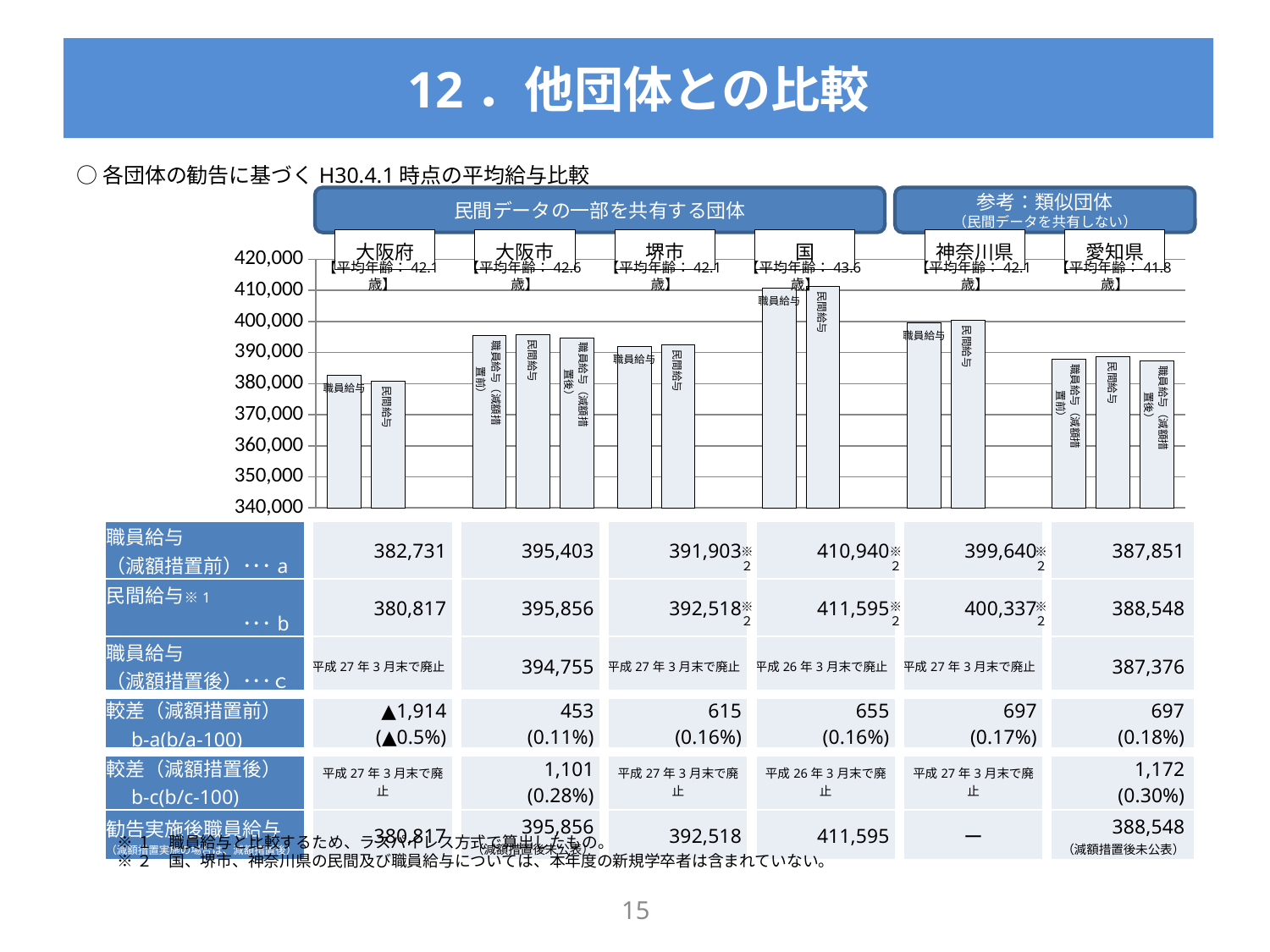
What is the difference (較差, b-a) between 民間給与 and 職員給与（減額措置前） for 大阪市? 453 What kind of chart is shown on the slide? bar chart How many organizations (団体) are compared in the chart? 6 What average age (平均年齢) is shown for 国 in the chart? 43.6歳 What is the 職員給与（減額措置前） value for 大阪府? 382,731 Which organization has the lowest 民間給与? 大阪府 Is the 民間給与 value for 国 greater or less than 400,000? greater What is the 職員給与（減額措置後） value for 愛知県? 387,376 What is the 民間給与 value for 国? 411,595 Is the 民間給与 value for 大阪府 greater or less than 390,000? less Which organization has the highest 職員給与（減額措置前）? 国 For 大阪府, which is larger: 職員給与 or 民間給与? 職員給与